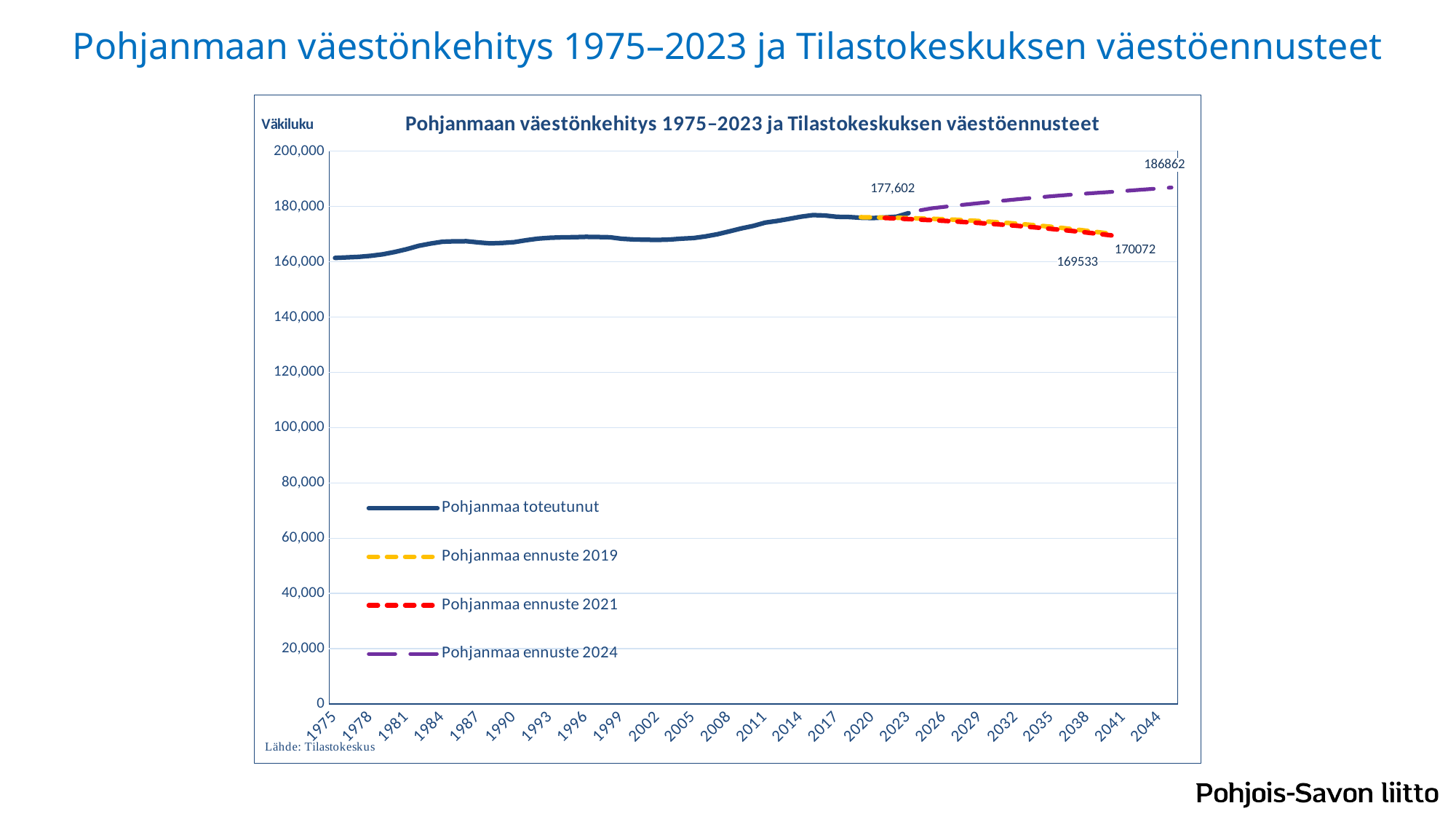
Does the Pohjanmaa toteutunut series generally rise or fall from 1975 to 2023? rise What is the lowest value printed as a data label on the chart? 169533 Around 2040, which is higher: Pohjanmaa ennuste 2024 or Pohjanmaa ennuste 2021? Pohjanmaa ennuste 2024 What is the labelled end value of the Pohjanmaa ennuste 2024 series? 186862 What label is shown on the vertical axis of the chart? Väkiluku What is the labelled value of the Pohjanmaa toteutunut series at its end in 2023? 177,602 Which series reaches the highest value on the chart? Pohjanmaa ennuste 2024 What kind of chart is shown on the slide? line chart What is the difference between the end value of Pohjanmaa ennuste 2024 (186862) and the 2023 actual value (177,602)? 9260 How many series does the legend list? 4 What is the title of the chart? Pohjanmaan väestönkehitys 1975–2023 ja Tilastokeskuksen väestöennusteet Is the Pohjanmaa toteutunut value in 1975 greater or less than 180,000? less